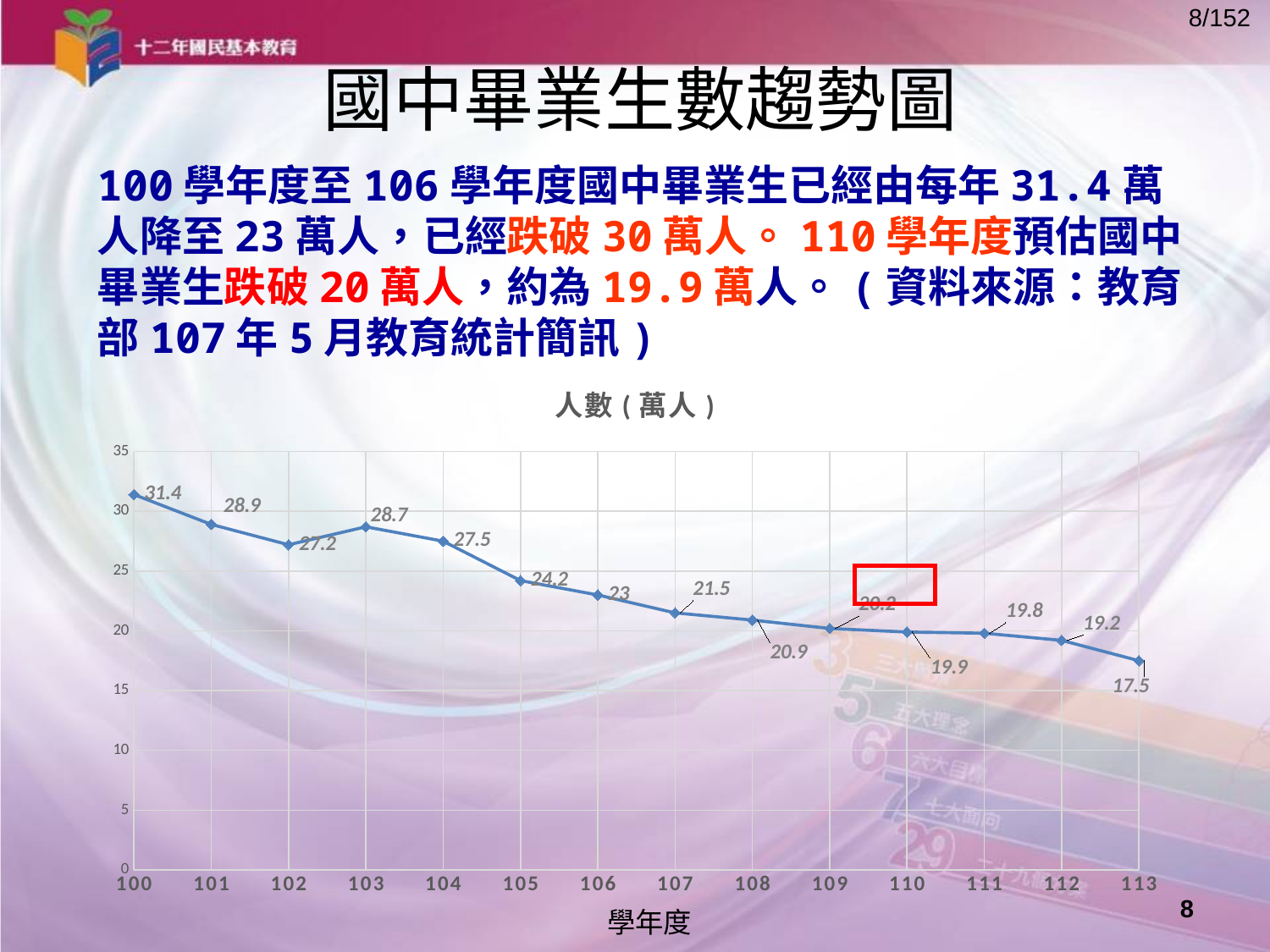
Which 學年度 has the lowest value? 113 Is the value for 學年度 105 greater or less than 25? less What is the value for 學年度 110? 19.9 How many 學年度 data points are plotted on the chart? 14 Which is larger, the value for 學年度 102 or 學年度 103? 103 What is the title of the chart? 人數（萬人） Which 學年度 has the highest value? 100 What kind of chart is shown on the slide? line chart What is the value for 學年度 113? 17.5 What is the value for 學年度 106? 23 What is the value for 學年度 100? 31.4 What is the difference between the values for 學年度 100 and 學年度 106? 8.4